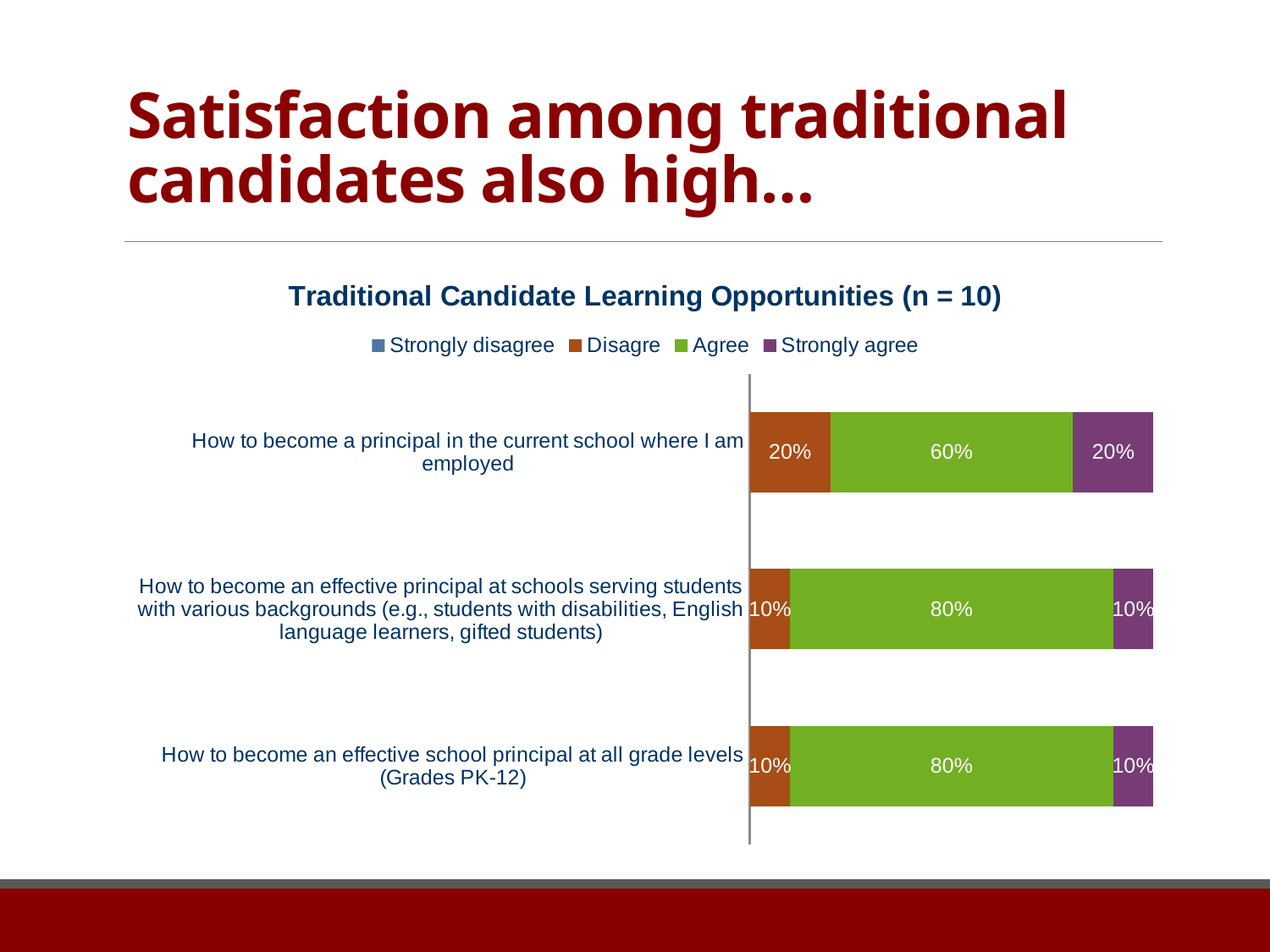
What percentage of respondents chose 'Disagre' for 'How to become an effective principal at schools serving students with various backgrounds'? 10% How many categories (bars) are shown in the chart? 3 What percentage of respondents chose 'Strongly agree' for 'How to become a principal in the current school where I am employed'? 20% What kind of chart is shown on the slide? Stacked bar chart Which is larger: the 'Strongly agree' percentage for 'How to become a principal in the current school where I am employed' or for 'How to become an effective school principal at all grade levels (Grades PK-12)'? How to become a principal in the current school where I am employed Which category has the lowest 'Agree' percentage? How to become a principal in the current school where I am employed How many series does the legend list? 4 What percentage of respondents chose 'Agree' for 'How to become a principal in the current school where I am employed'? 60% What is the difference between the 'Agree' percentage for 'How to become an effective school principal at all grade levels (Grades PK-12)' and for 'How to become a principal in the current school where I am employed'? 20% What is the title of the chart? Traditional Candidate Learning Opportunities (n = 10) Which category has the highest 'Agree' percentage? How to become an effective principal at schools serving students with various backgrounds and How to become an effective school principal at all grade levels (Grades PK-12) (both 80%) What percentage of respondents chose 'Agree' for 'How to become an effective school principal at all grade levels (Grades PK-12)'? 80%